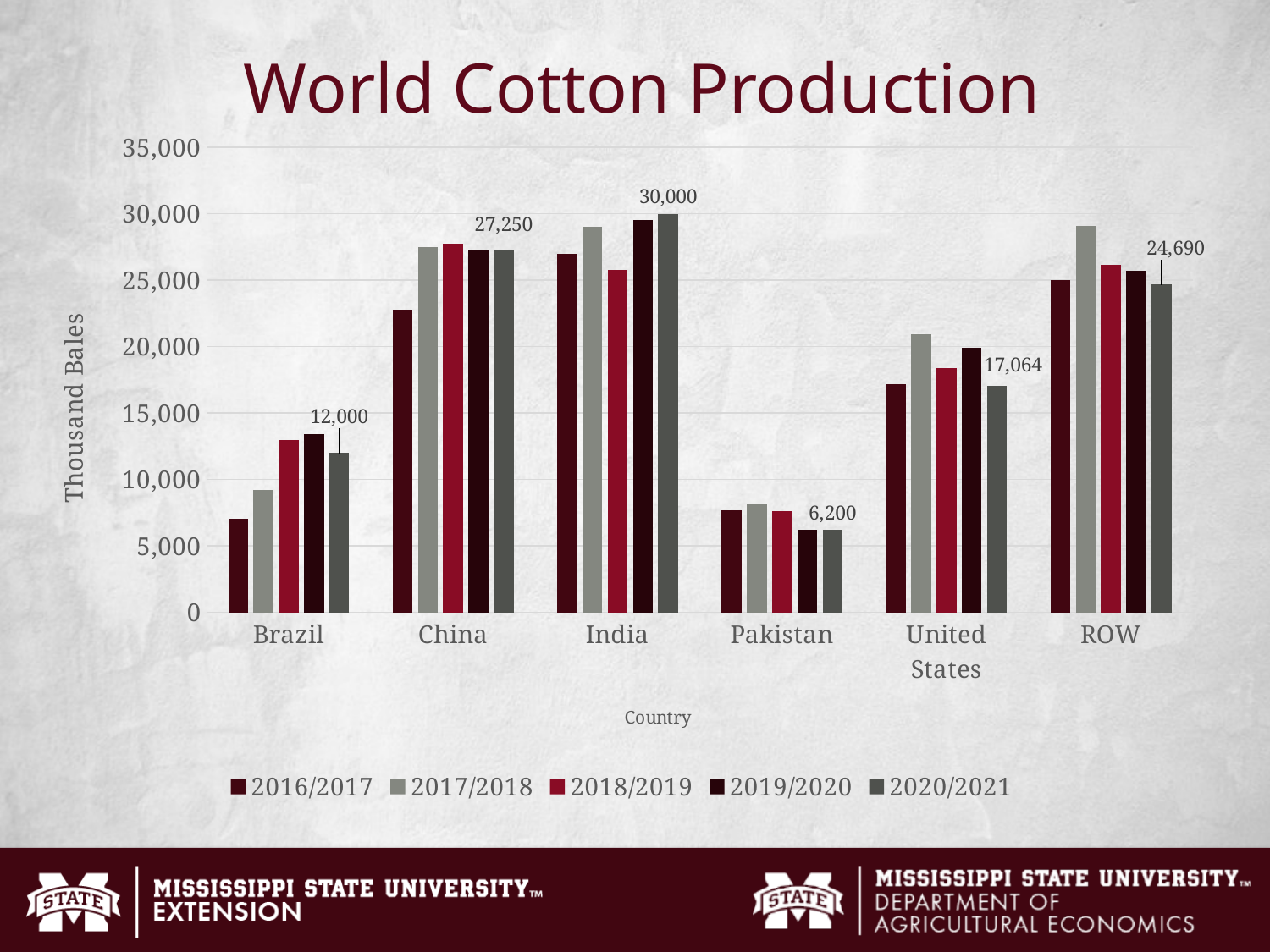
For 2020/2021, which is larger: China's value or ROW's value? China What is the label on the vertical axis? Thousand Bales What is the difference between the 2020/2021 values for India and China? 2,750 What is the 2020/2021 cotton production value shown for India? 30,000 How many series does the legend list? 5 What is the 2020/2021 value labeled for the United States? 17,064 What is the 2020/2021 value labeled for ROW? 24,690 Which country has the lowest labeled 2020/2021 production value? Pakistan Which country has the highest labeled 2020/2021 production value? India How many countries/categories are shown on the x axis? 6 What is the 2020/2021 value labeled for China? 27,250 Is the 2016/2017 value for Brazil greater or less than 10,000? less